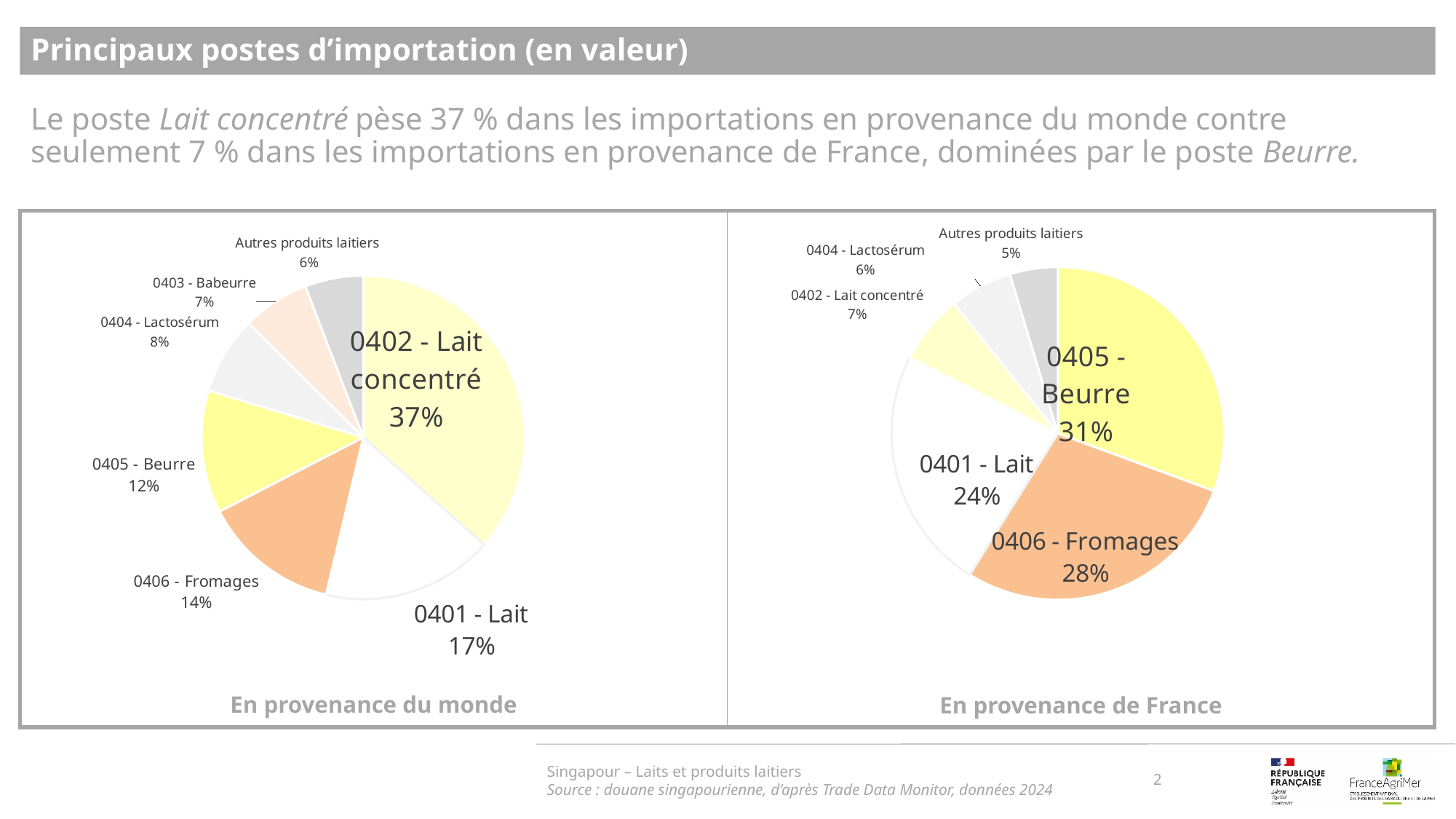
In the 'En provenance du monde' chart, which category has the largest share? 0402 - Lait concentré In the 'En provenance du monde' chart, what is the difference between the shares of 0401 - Lait and 0405 - Beurre? 5 percentage points In the 'En provenance du monde' chart, what share does 0402 - Lait concentré have? 37% In the 'En provenance de France' chart, which category has the smallest share? Autres produits laitiers What is the title of the chart on the left side of the slide? En provenance du monde In the 'En provenance de France' chart, what share does 0402 - Lait concentré have? 7% In the 'En provenance de France' chart, what share does 0405 - Beurre have? 31% What type of chart is the 'En provenance de France' chart? Pie chart How many slices does the 'En provenance du monde' chart have? 7 In the 'En provenance du monde' chart, what share does 0406 - Fromages have? 14% How many slices does the 'En provenance de France' chart have? 6 In the 'En provenance de France' chart, which is larger: 0406 - Fromages or 0401 - Lait? 0406 - Fromages